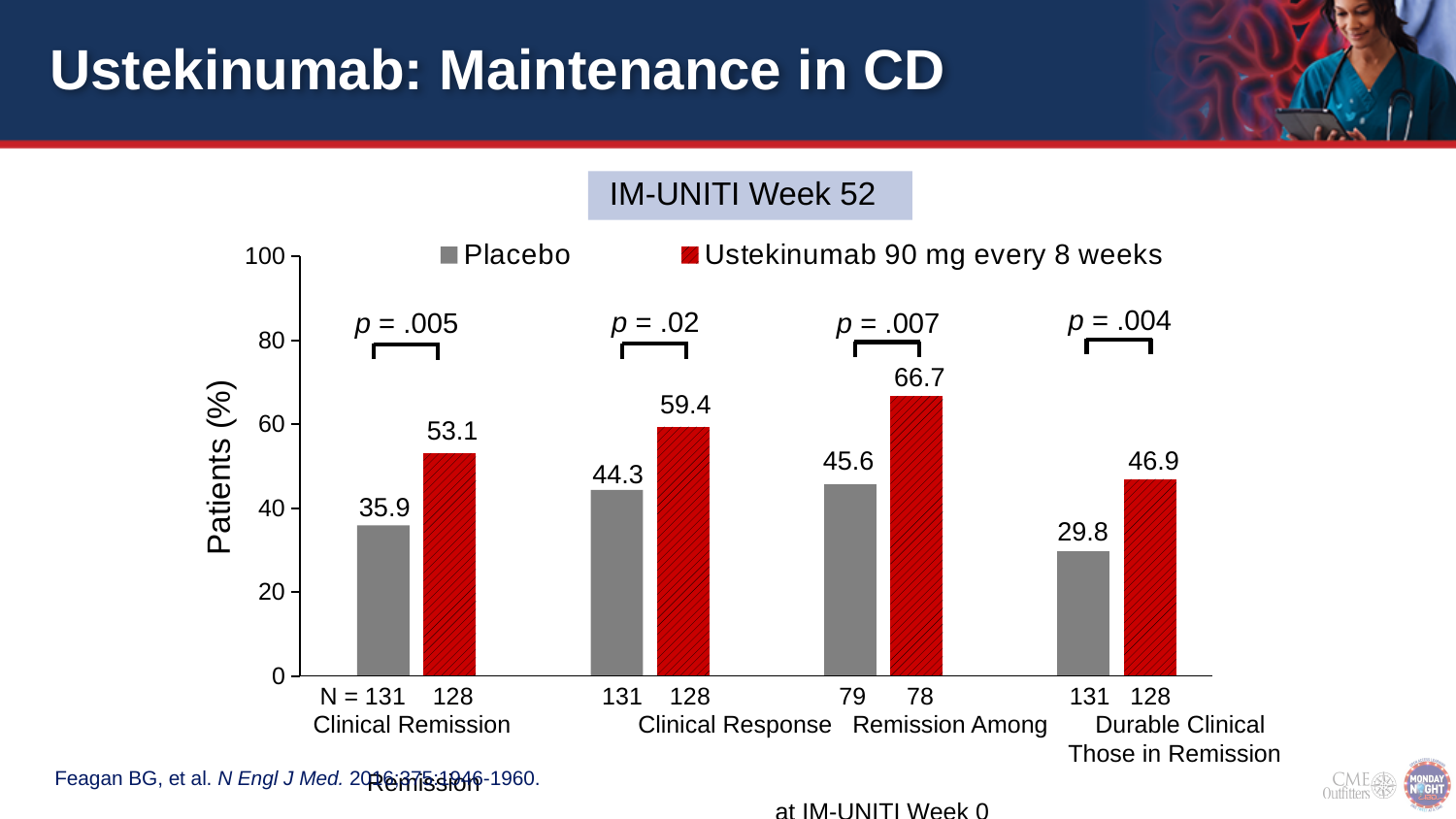
What is the Ustekinumab 90 mg every 8 weeks value for Clinical Response? 59.4 How many categories are shown on the x axis? 4 What is the difference between the Ustekinumab and Placebo values for Clinical Remission? 17.2 What is the Placebo value for Durable Clinical Remission? 29.8 What kind of chart is shown on the slide? Bar chart What is the y-axis label of the chart? Patients (%) What is the Placebo value for Clinical Remission? 35.9 Which is larger for Clinical Response: the Placebo value or the Ustekinumab 90 mg every 8 weeks value? Ustekinumab 90 mg every 8 weeks Which category has the highest Ustekinumab 90 mg every 8 weeks value? Remission Among Those in Remission at IM-UNITI Week 0 Is the Ustekinumab value for Remission Among Those in Remission at IM-UNITI Week 0 greater or less than 60? greater Which category has the lowest Placebo value? Durable Clinical Remission How many series does the legend list? 2